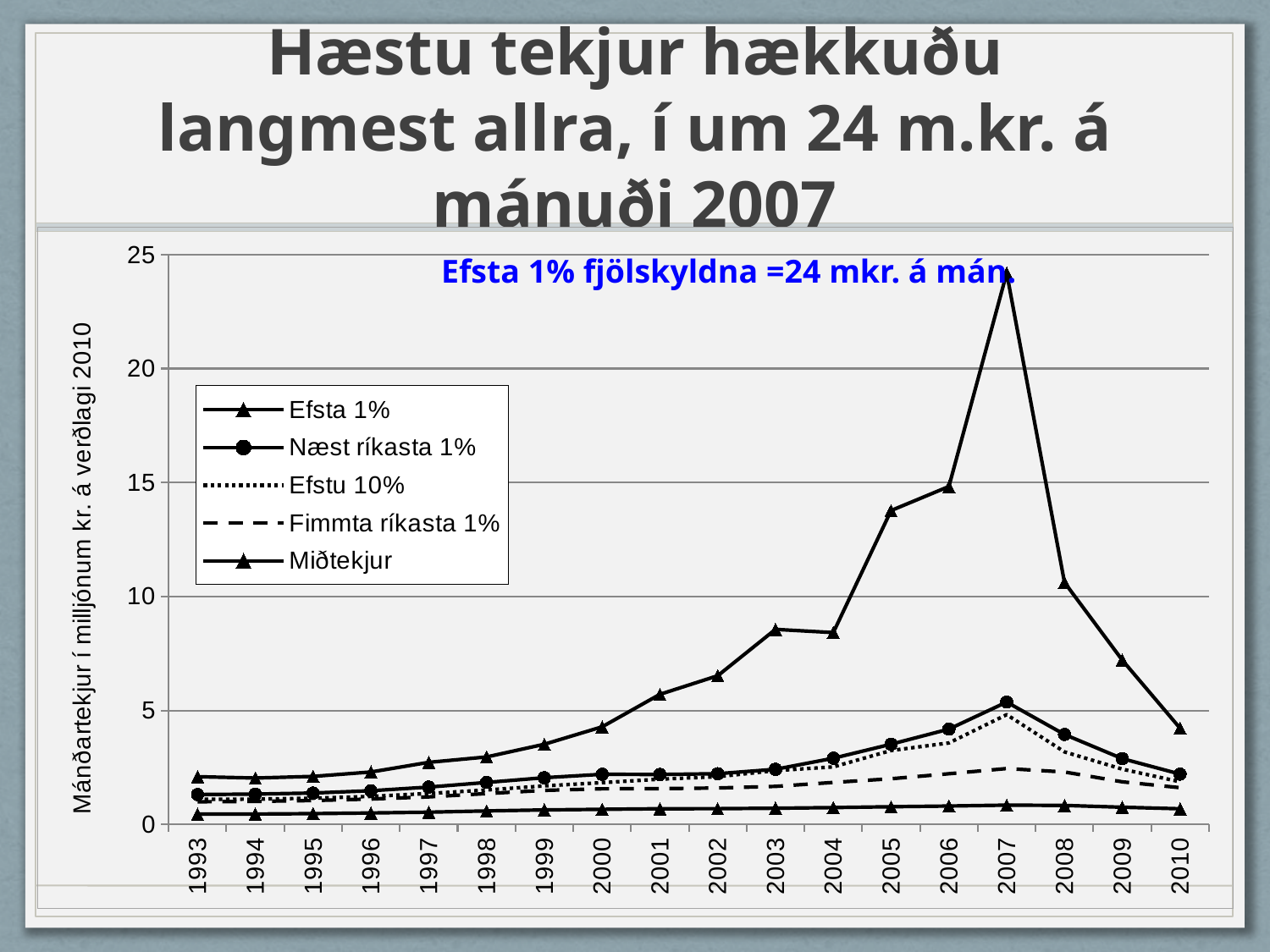
Does the Efsta 1% series rise or fall from 2007 to 2010? fall Is the value for Efsta 1% in 2007 greater or less than 20? greater In which year does the Efsta 1% series reach its highest value? 2007 What kind of chart is shown on the slide? line chart Is the value for Næst ríkasta 1% in 2005 greater or less than 5? less What is the label on the y axis? Mánaðartekjur í milljónum kr. á verðlagi 2010 Is the value for Efsta 1% in 2010 greater or less than 5? less In 2007, which series has the larger value: Næst ríkasta 1% or Miðtekjur? Næst ríkasta 1% How many years are shown on the x axis? 18 Which series has the lowest value in 2007? Miðtekjur How many series does the legend list? 5